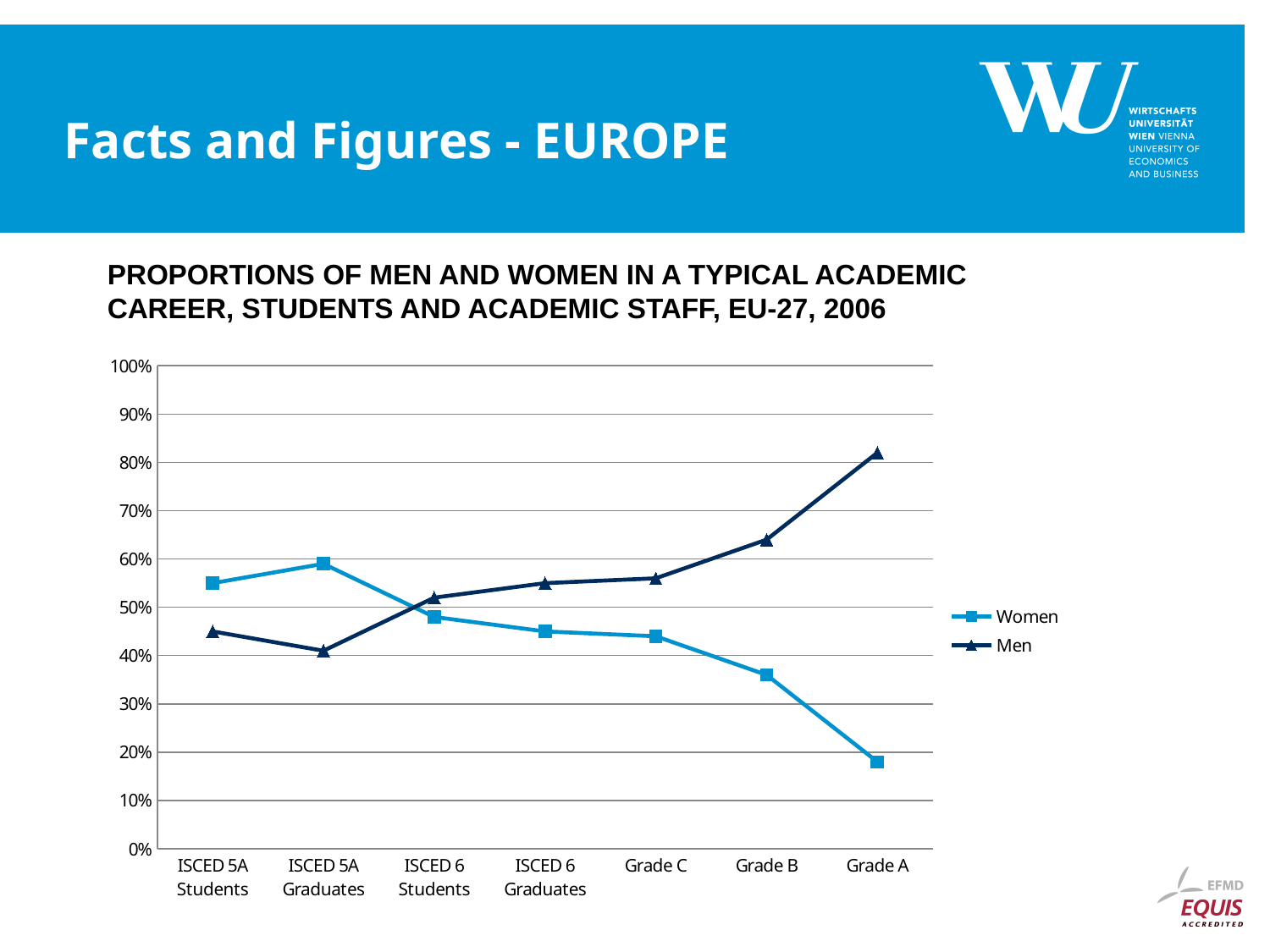
Is the value for Women at Grade B greater or less than 40%? less For which category is the Women series highest? ISCED 5A Graduates How many series does the legend list? 2 What are the two entries in the chart's legend? Women and Men For which category is the Men series lowest? ISCED 5A Graduates At Grade C, which series has the larger value, Men or Women? Men Does the Women series overall rise or fall from ISCED 5A Students to Grade A? fall What kind of chart is shown on the slide? line chart How many categories are shown along the x axis? 7 Is the value for Men at Grade A greater or less than 70%? greater For which category is the Women series lowest? Grade A For which category is the Men series highest? Grade A